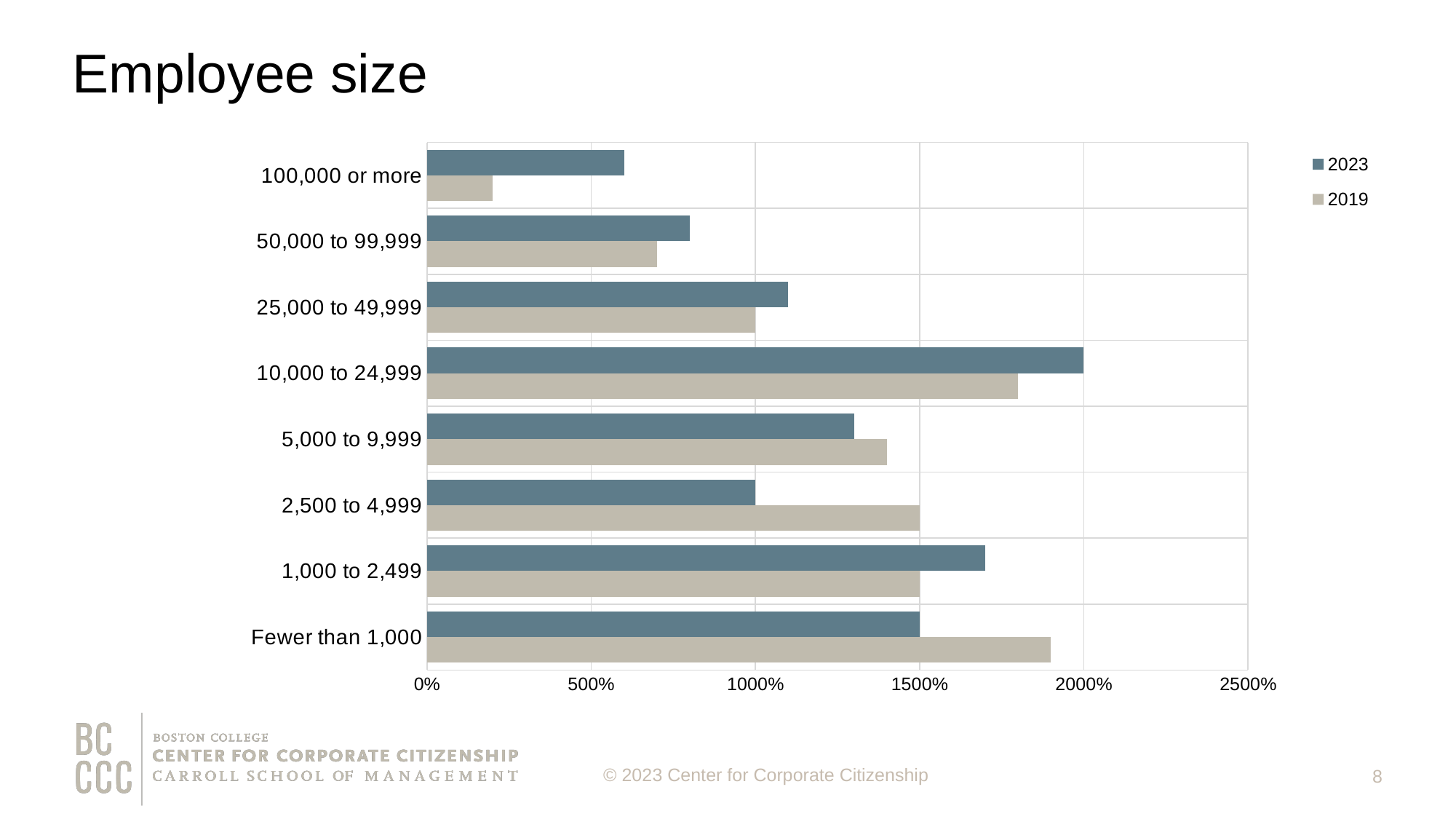
Is the 2023 value for 1,000 to 2,499 greater or less than 1500%? greater What is the 2023 value for the 10,000 to 24,999 category? 2000% Is the 2019 value for 5,000 to 9,999 greater or less than 1500%? less For the 100,000 or more category, which series has the larger value, 2023 or 2019? 2023 What is the 2023 value for the Fewer than 1,000 category? 1500% What is the difference between the 2019 and 2023 values for the 2,500 to 4,999 category? 500% What is the 2019 value for the 2,500 to 4,999 category? 1500% How many employee size categories are shown on the chart? 8 Which category has the highest 2023 value? 10,000 to 24,999 How many series does the legend list? 2 What kind of chart is shown on the slide? bar chart Which category has the lowest 2019 value? 100,000 or more